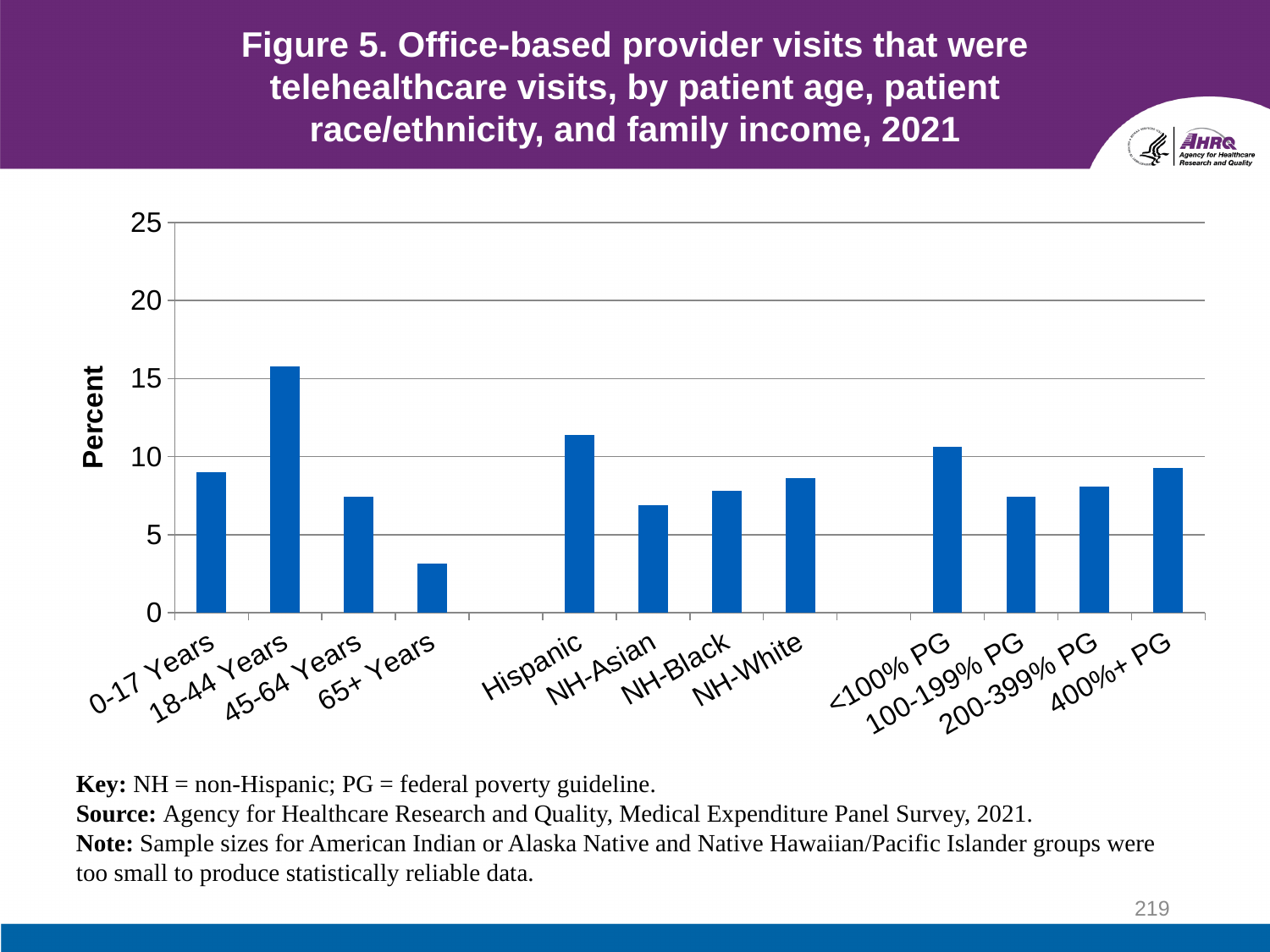
Which is larger, the value for Hispanic or the value for NH-Asian? Hispanic Is the value for 18-44 Years greater or less than 15? greater Is the value for NH-Asian greater or less than 10? less Is the value for <100% PG greater or less than 10? greater What kind of chart is shown on the slide? bar chart Which category has the highest percentage of office-based provider visits that were telehealthcare visits? 18-44 Years How many categories are plotted on the chart? 12 What is the label on the vertical axis of the chart? Percent Which is larger, the value for <100% PG or the value for 100-199% PG? <100% PG Which category has the lowest percentage of office-based provider visits that were telehealthcare visits? 65+ Years